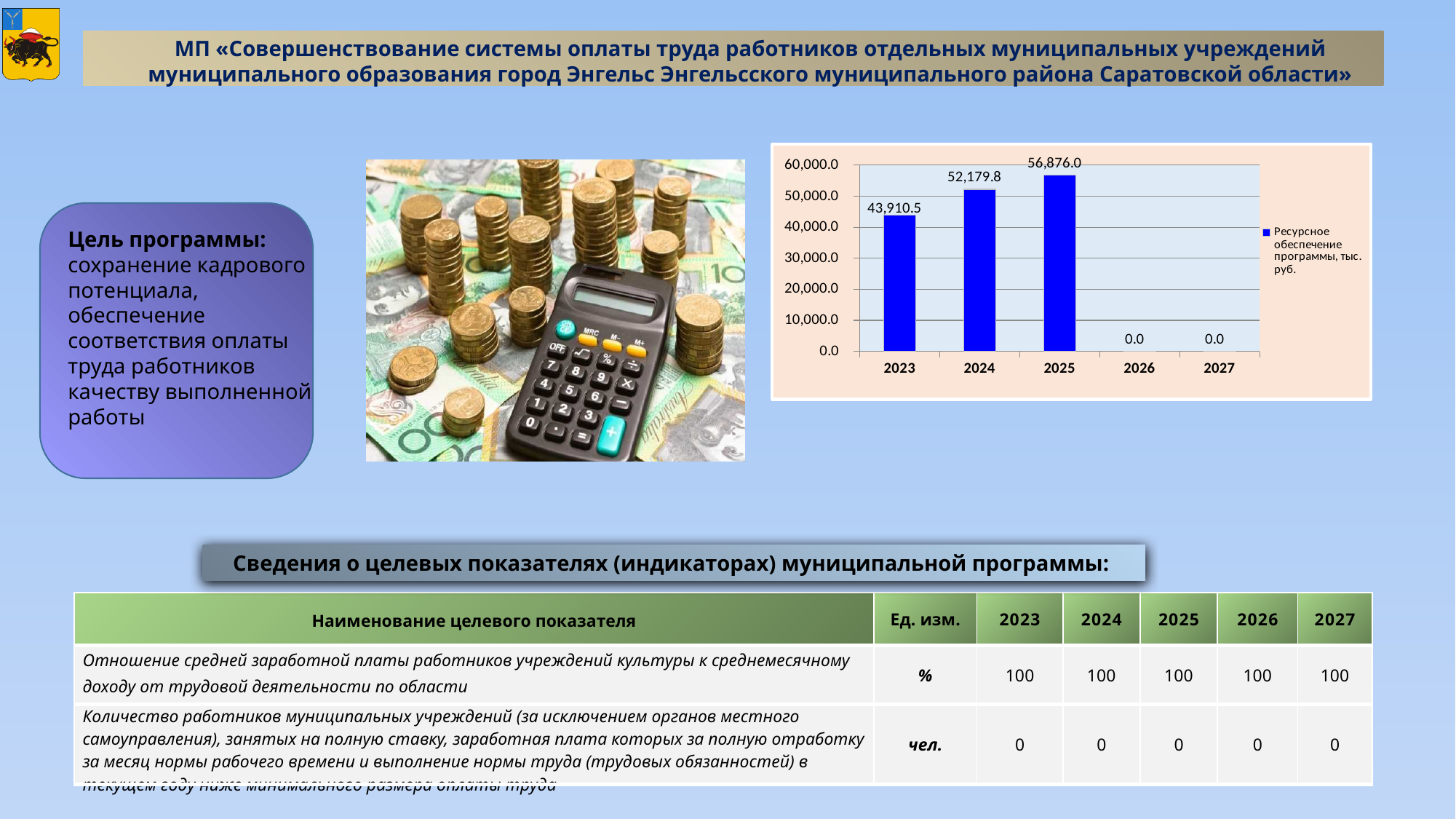
What is the difference between the values for 2025 and 2024? 4,696.2 What is the difference between the values for 2024 and 2023? 8,269.3 Which is larger, the value for 2023 or the value for 2025? 2025 Which year has the highest value in the chart? 2025 What is the value for 2023 in the chart? 43,910.5 How many years are shown on the x axis of the chart? 5 What is the value for 2025 in the chart? 56,876.0 Is the value for 2024 greater or less than 50,000.0? greater What is the value for 2024 in the chart? 52,179.8 What type of chart is shown on the slide? bar chart What is the legend entry of the chart? Ресурсное обеспечение программы, тыс. руб. What is the value shown for 2026 in the chart? 0.0